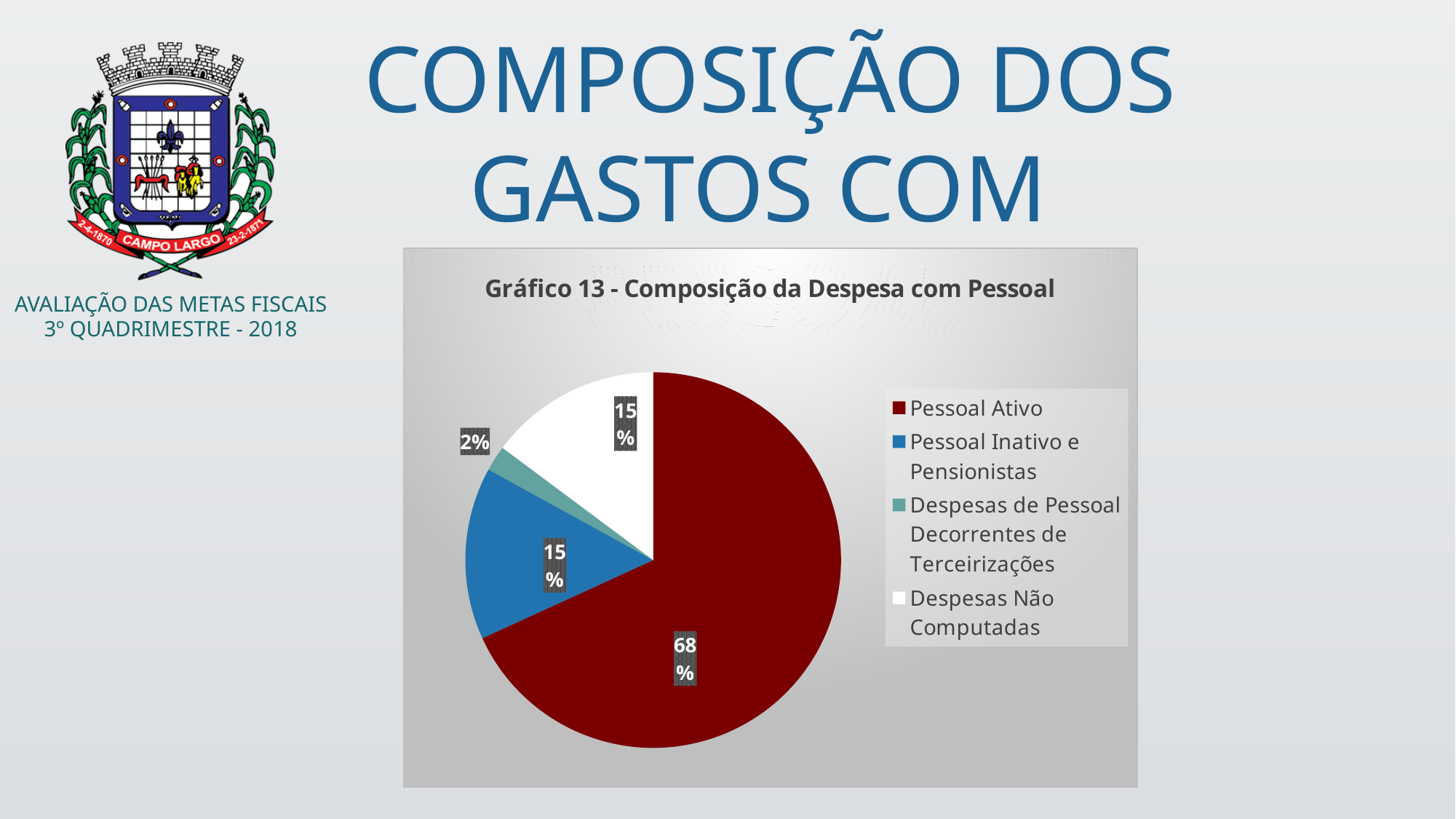
What share of the pie does Pessoal Ativo represent? 68% What type of chart is shown on the slide? Pie chart What share of the pie does Despesas Não Computadas represent? 15% What colour is the slice for Pessoal Inativo e Pensionistas? Blue Which is larger: the slice for Pessoal Ativo or the slice for Despesas Não Computadas? Pessoal Ativo What is the title of the chart? Gráfico 13 - Composição da Despesa com Pessoal What share of the pie does Pessoal Inativo e Pensionistas represent? 15% Which category has the smallest slice of the pie? Despesas de Pessoal Decorrentes de Terceirizações Which category has the largest slice of the pie? Pessoal Ativo How many categories are shown in the pie chart? 4 What is the difference in percentage points between Pessoal Ativo and Pessoal Inativo e Pensionistas? 53 percentage points